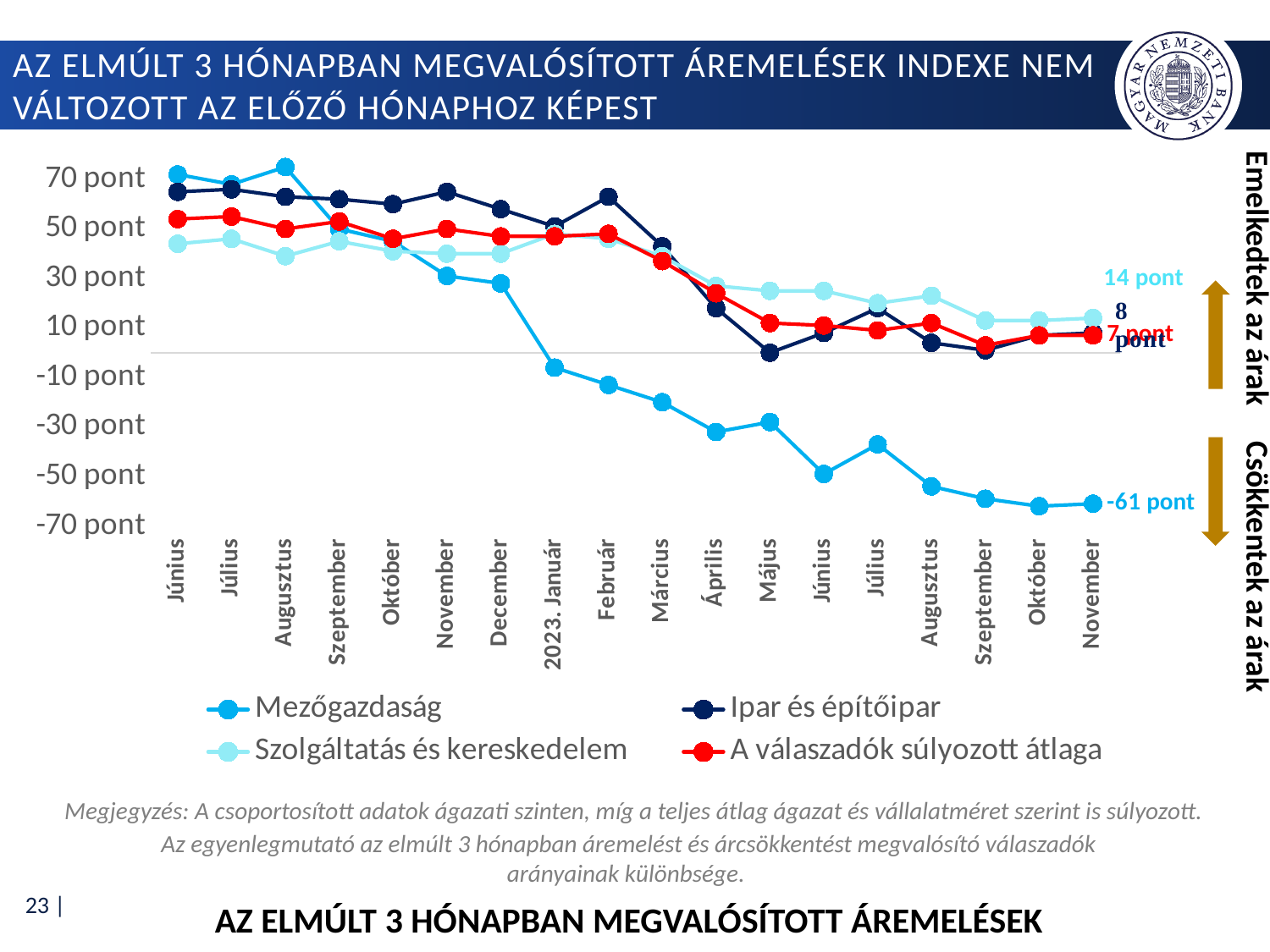
What is the value for Szolgáltatás és kereskedelem in the last November shown? 14 pont How many months are shown along the x axis? 18 What is the value for Ipar és építőipar in the last November shown? 8 pont Does the Mezőgazdaság series generally rise or fall from the first Június to the last November? fall In the last November shown, which is larger: Szolgáltatás és kereskedelem or Ipar és építőipar? Szolgáltatás és kereskedelem What is the difference between Szolgáltatás és kereskedelem and Mezőgazdaság in the last November shown? 75 pont What type of chart is shown on the slide? line chart What is the value for A válaszadók súlyozott átlaga in the last November shown? 7 pont How many series does the legend list? 4 Is the value for Mezőgazdaság in the first Június shown greater or less than 50 pont? greater Which series has the lowest value in the last November shown? Mezőgazdaság What is the value for Mezőgazdaság in the last November shown? -61 pont